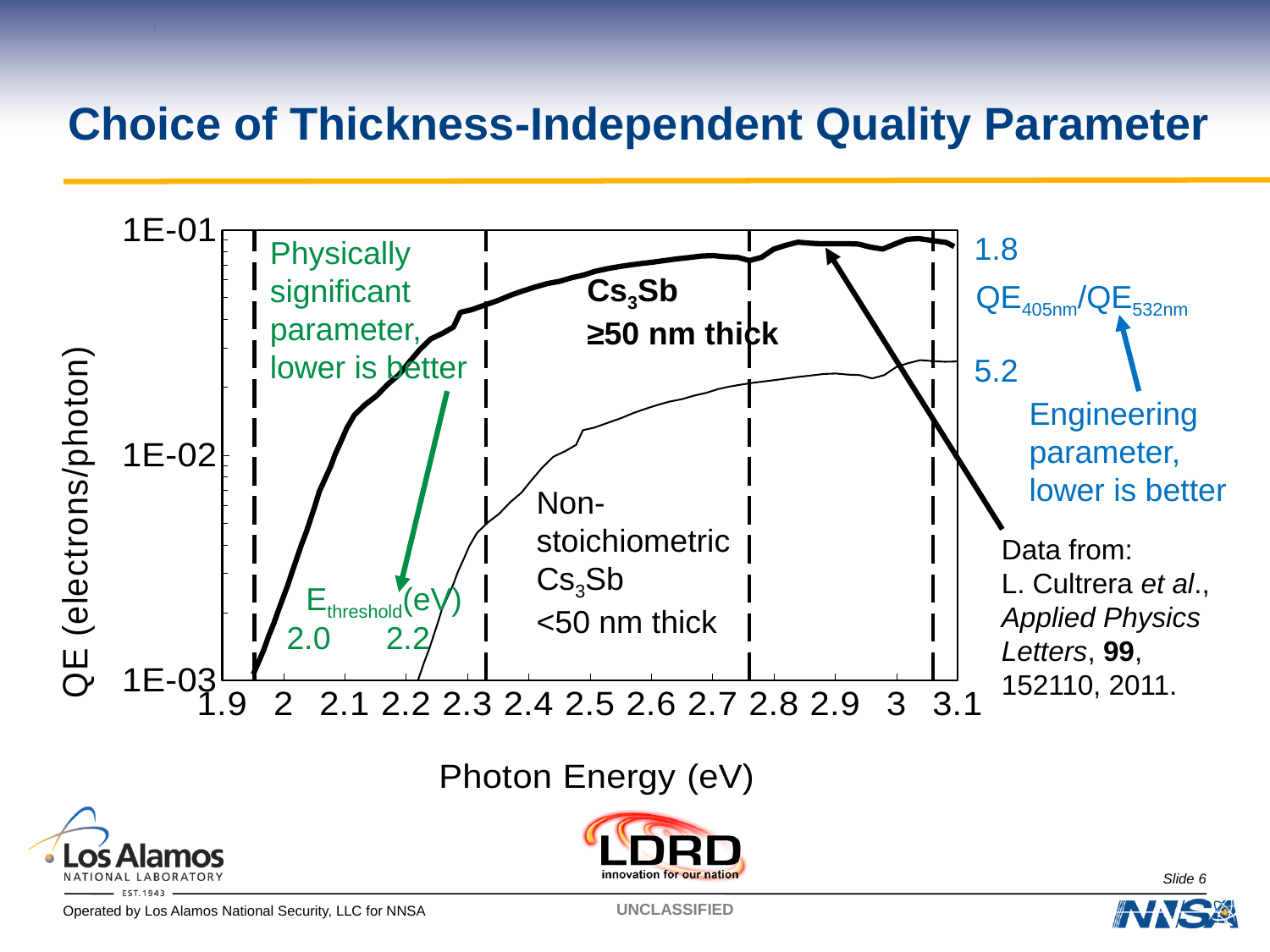
Is the QE of Cs3Sb ≥50 nm thick at 2.5 eV greater or less than 1E-02? greater What is the lowest photon energy value shown on the x axis? 1.9 Which curve reaches the higher QE values, Cs3Sb ≥50 nm thick or non-stoichiometric Cs3Sb <50 nm thick? Cs3Sb ≥50 nm thick At 2.6 eV, which curve has the higher QE, Cs3Sb ≥50 nm thick or non-stoichiometric Cs3Sb <50 nm thick? Cs3Sb ≥50 nm thick What two E_threshold values (eV) are annotated on the chart? 2.0 and 2.2 Does the QE of Cs3Sb ≥50 nm thick rise or fall as photon energy increases from 1.9 to 2.8 eV? rise What is the label of the x axis? Photon Energy (eV) Is the QE of non-stoichiometric Cs3Sb <50 nm thick at 2.3 eV greater or less than 1E-02? less Is the QE of Cs3Sb ≥50 nm thick at 2.0 eV greater or less than 1E-02? less How many curves are plotted on the chart? 2 What is the label of the y axis? QE (electrons/photon) What type of chart is shown on the slide? line chart